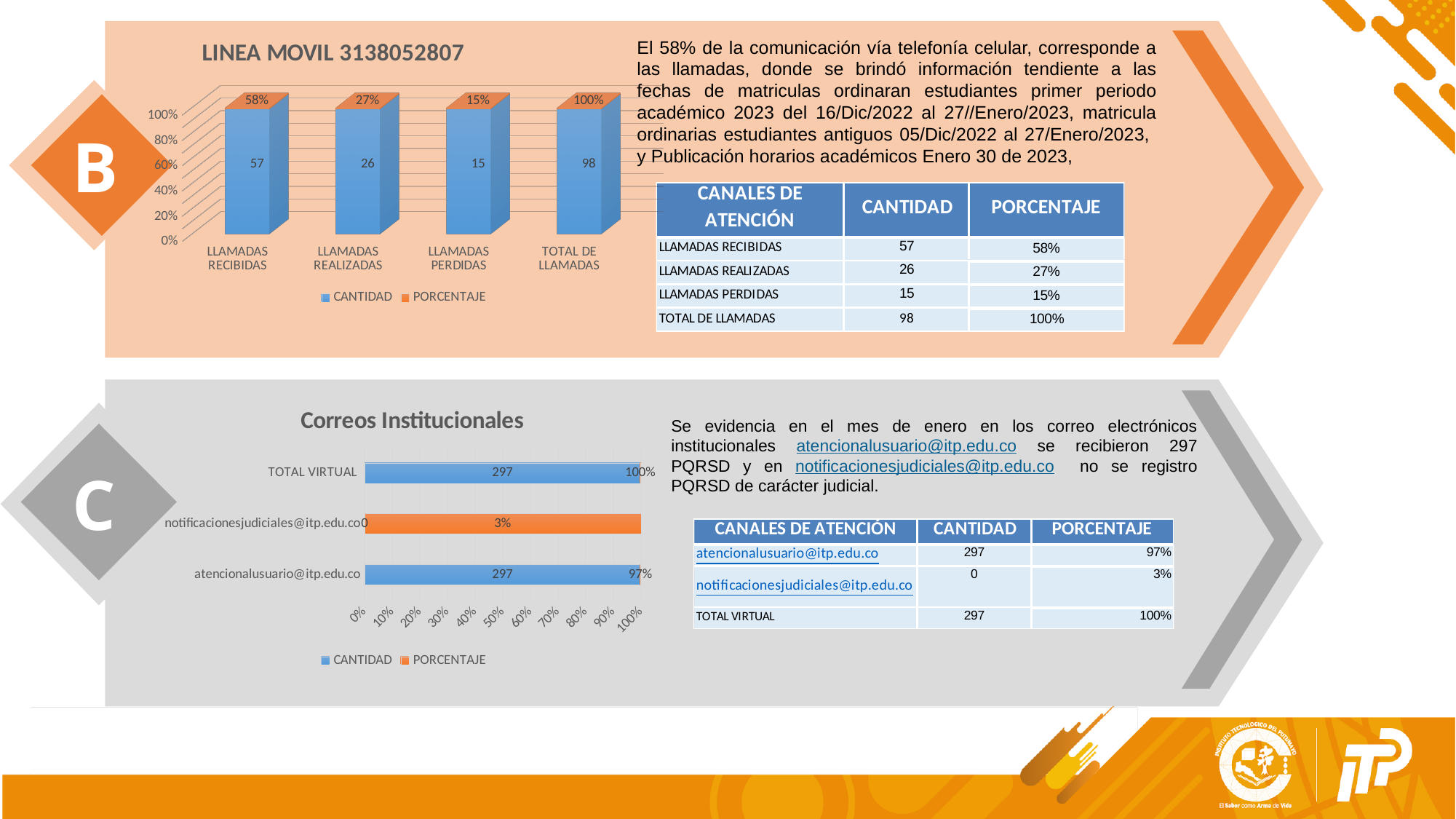
In the LINEA MOVIL 3138052807 chart, how many categories are shown on the x axis? 4 In the LINEA MOVIL 3138052807 chart, what is the difference between the CANTIDAD values for LLAMADAS RECIBIDAS and LLAMADAS REALIZADAS? 31 In the Correos Institucionales chart, which category has a larger CANTIDAD value: atencionalusuario@itp.edu.co or notificacionesjudiciales@itp.edu.co? atencionalusuario@itp.edu.co What is the title of the chart in the top section of the slide? LINEA MOVIL 3138052807 In the LINEA MOVIL 3138052807 chart, what is the CANTIDAD value for LLAMADAS RECIBIDAS? 57 In the LINEA MOVIL 3138052807 chart, how many series does the legend list? 2 In the LINEA MOVIL 3138052807 chart, what PORCENTAJE is shown for LLAMADAS REALIZADAS? 27% In the Correos Institucionales chart, what PORCENTAJE is shown for notificacionesjudiciales@itp.edu.co? 3% In the LINEA MOVIL 3138052807 chart, which category has the lowest CANTIDAD value? LLAMADAS PERDIDAS In the Correos Institucionales chart, how many categories are shown? 3 What type of chart is the Correos Institucionales chart? Bar chart In the Correos Institucionales chart, what is the CANTIDAD value for atencionalusuario@itp.edu.co? 297